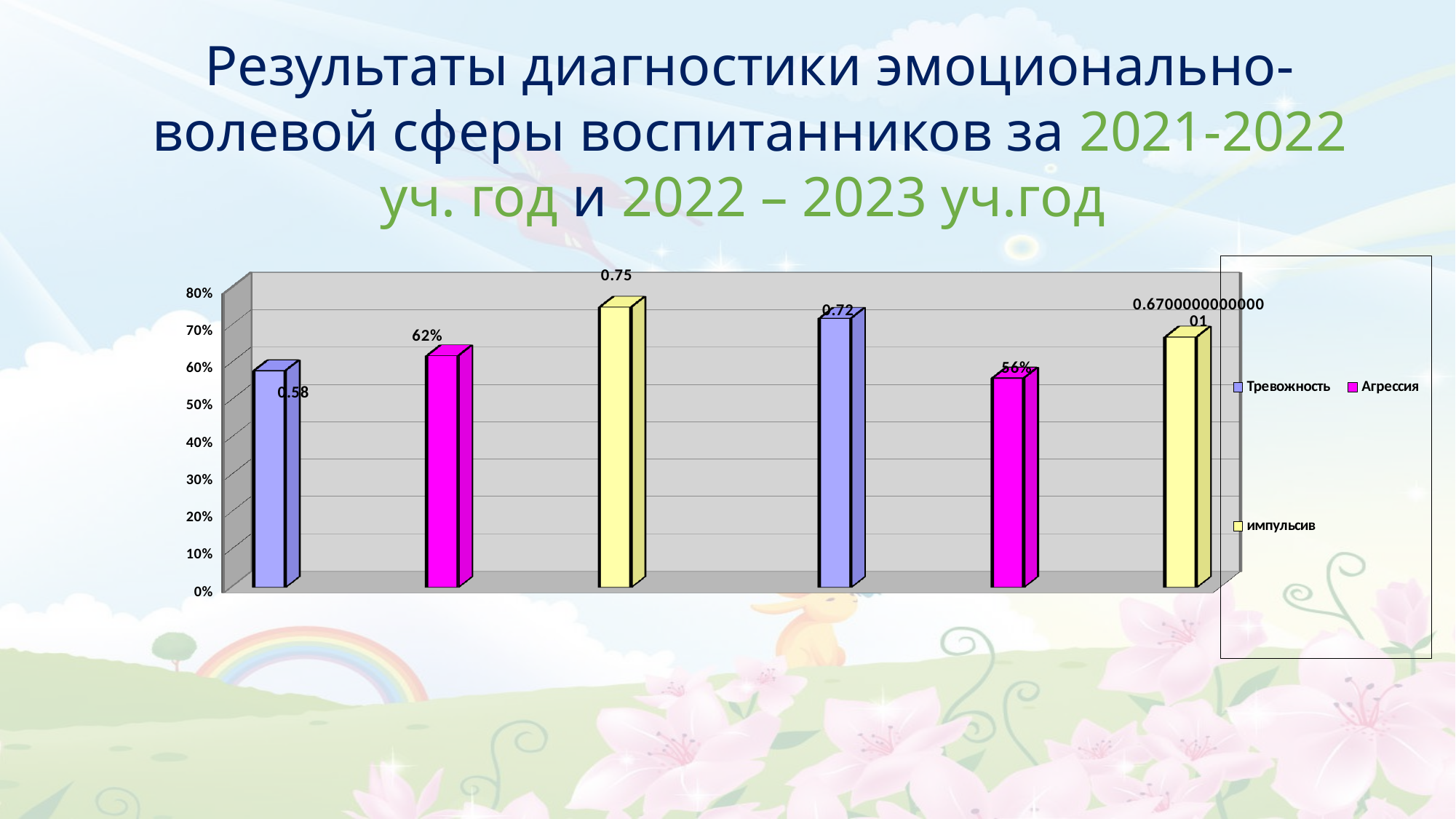
How many series does the chart legend list? 3 Which is larger: the first Тревожность bar or the second Тревожность bar? the second Тревожность bar What value is labelled on the left-most (first) Тревожность bar? 0.58 What type of chart is shown on the slide? bar chart What value is labelled on the second Агрессия bar from the left? 56% Which bar has the lowest value in the chart? the second Агрессия bar (56%) How many bars are plotted in the chart? 6 What colour represents the Агрессия series in the legend? magenta (pink) What value is labelled on the first импульсив bar from the left? 0.75 Is the value of the second импульсив bar from the left greater or less than 60%? greater What value is labelled on the second Тревожность bar from the left? 0.72 What value is labelled on the first Агрессия bar from the left? 62%